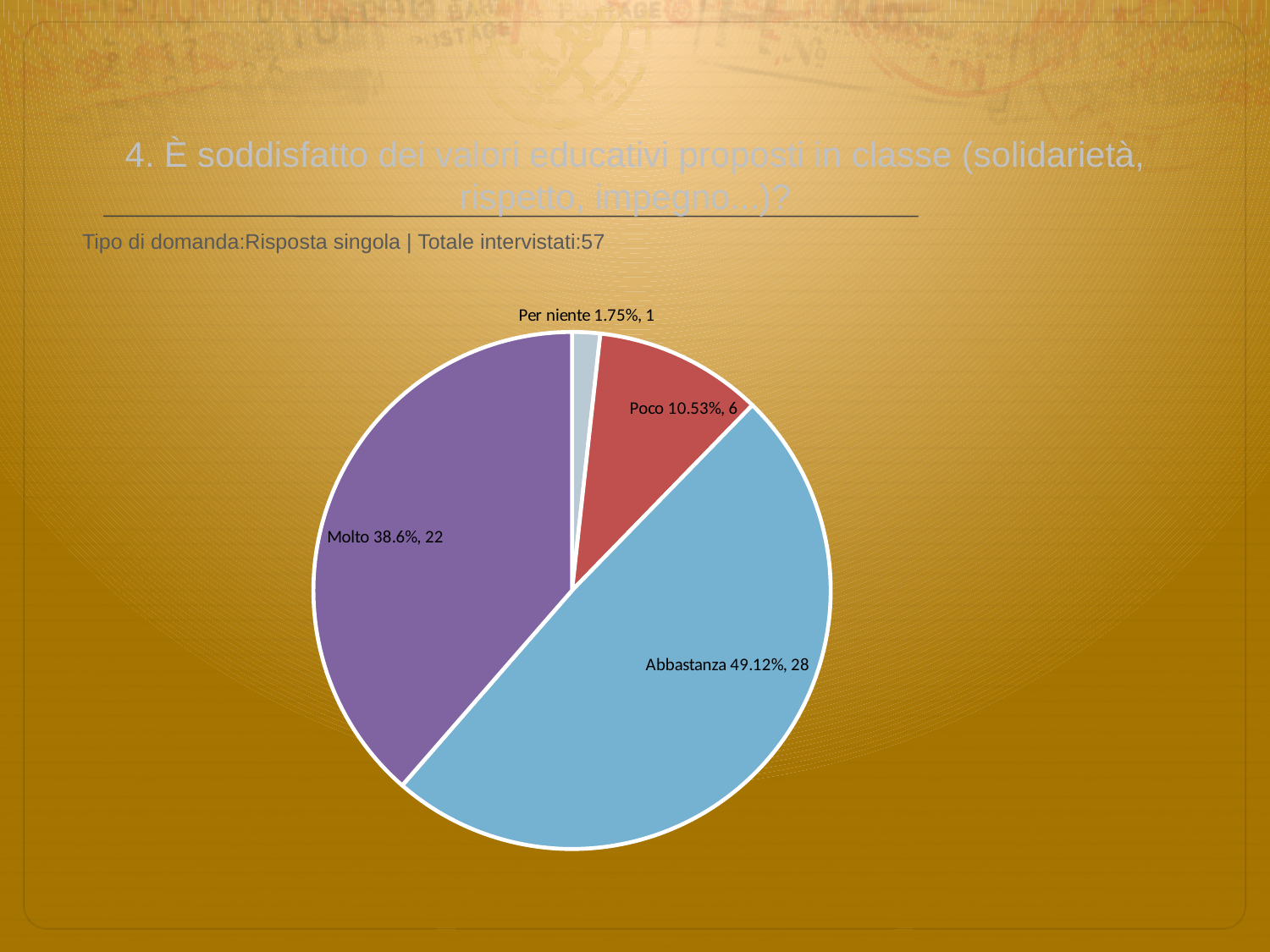
How many slices does the pie chart have? 4 What percentage share does the Abbastanza slice have? 49.12% What is the total number of respondents across all slices? 57 What percentage share does the Molto slice have? 38.6% Which has more respondents, Poco or Molto? Molto What kind of chart is shown on the slide? pie chart Which category has the largest slice? Abbastanza What percentage share does the Poco slice have? 10.53% What is the difference in respondent count between Abbastanza and Molto? 6 Which category has the smallest slice? Per niente How many respondents answered Per niente? 1 How many respondents answered Molto? 22